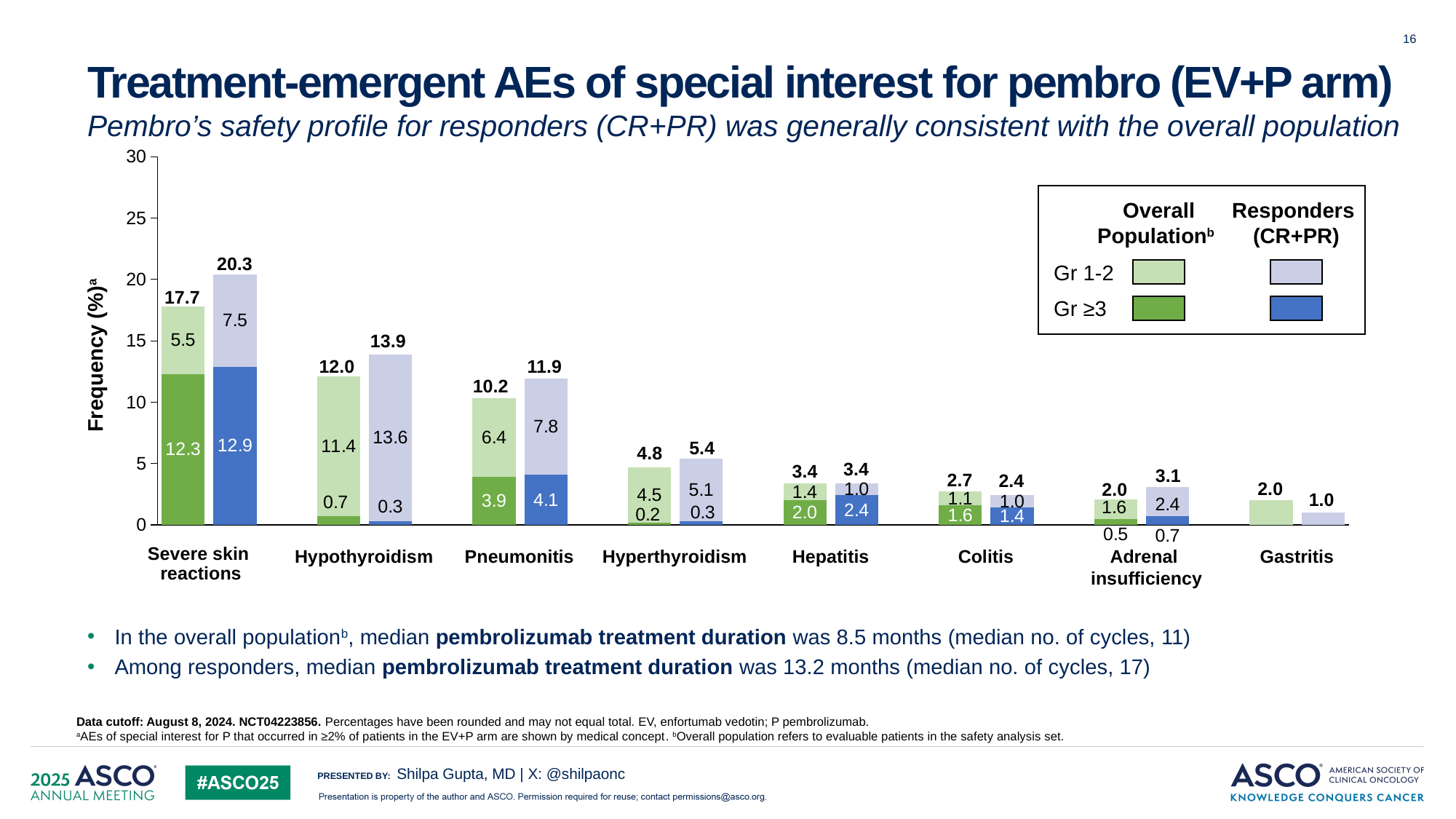
Which adverse event has the highest total frequency among responders (CR+PR)? Severe skin reactions What is the Gr ≥3 frequency of pneumonitis among responders (CR+PR)? 4.1 What is the total frequency of severe skin reactions in the overall population? 17.7 What is the total frequency of adrenal insufficiency among responders (CR+PR)? 3.1 What is the Gr 1-2 frequency of hypothyroidism among responders (CR+PR)? 13.6 Is the total frequency of pneumonitis in the overall population greater or less than 10? greater How many series does the legend list? 4 Which adverse event has the lowest total frequency among responders (CR+PR)? Gastritis How many adverse event categories are shown on the x axis? 8 What kind of chart is shown on the slide? Stacked bar chart What is the difference between the total frequency of severe skin reactions among responders and in the overall population? 2.6 Is the total frequency of hypothyroidism higher in the overall population or among responders (CR+PR)? Responders (CR+PR)